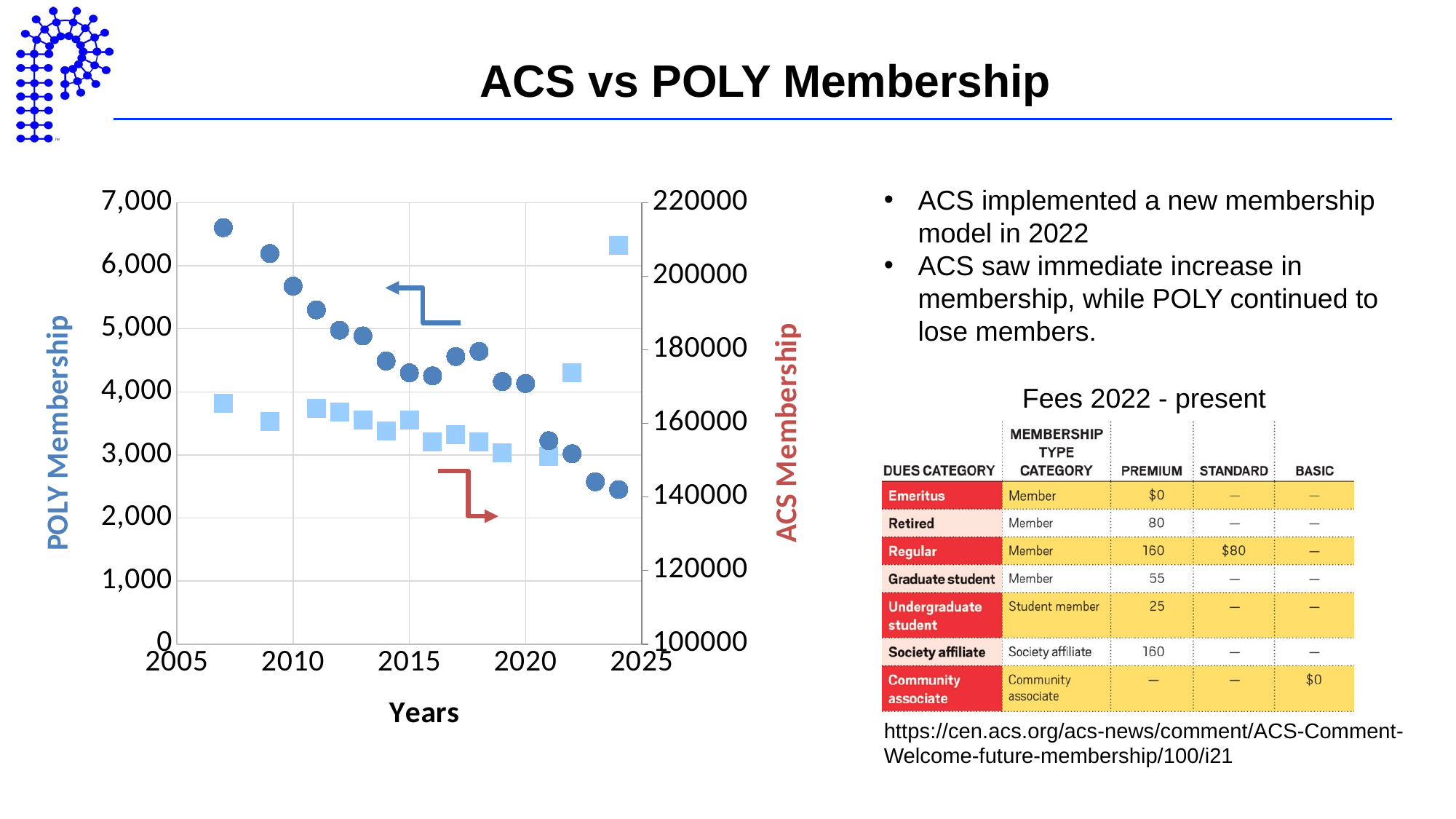
In which year is ACS Membership highest? 2024 Which series is plotted against the right-hand axis of the chart? ACS Membership Is the POLY Membership value for 2007 greater or less than 6,000? greater Is the ACS Membership value for 2021 greater or less than 160000? less How many data series are plotted on the chart? 2 Is the ACS Membership value for 2024 greater or less than 200000? greater Does POLY Membership rise or fall from 2007 to 2024? fall What is the title of the x axis of the chart? Years In which year is POLY Membership highest? 2007 What kind of chart is shown on the slide? scatter chart Which is larger, POLY Membership in 2007 or POLY Membership in 2020? 2007